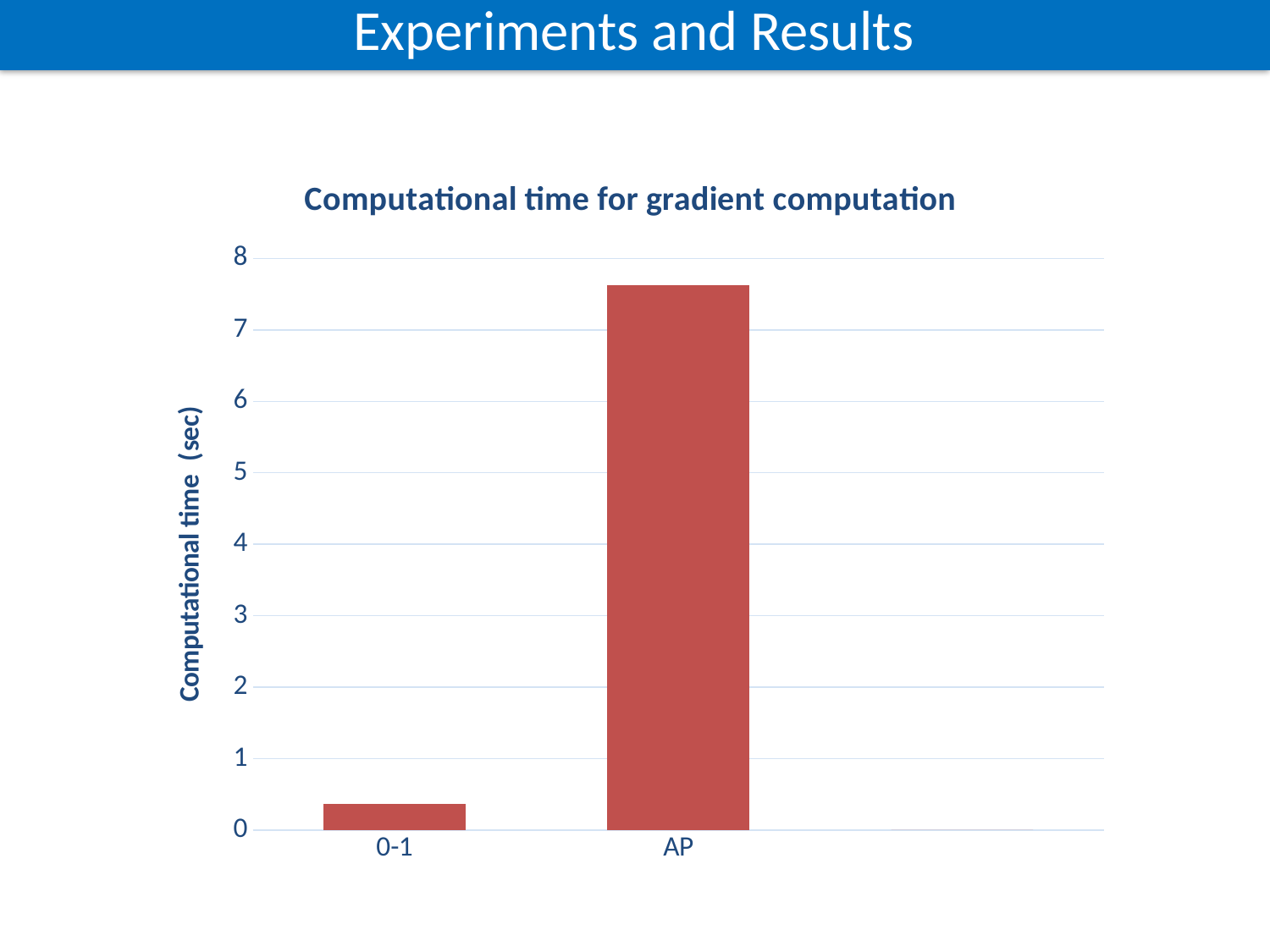
What kind of chart is shown on the slide? bar chart What is the label of the vertical axis? Computational time (sec) Do the values rise or fall from 0-1 to AP along the x axis? rise Which has a larger computational time, 0-1 or AP? AP Is the value for 0-1 greater or less than 1? less How many categories are shown on the x axis of the chart? 2 Which category has the highest computational time? AP Is the value for AP greater or less than 8? less Which category has the lowest computational time? 0-1 Is the value for AP greater or less than 7? greater What is the title of the chart? Computational time for gradient computation